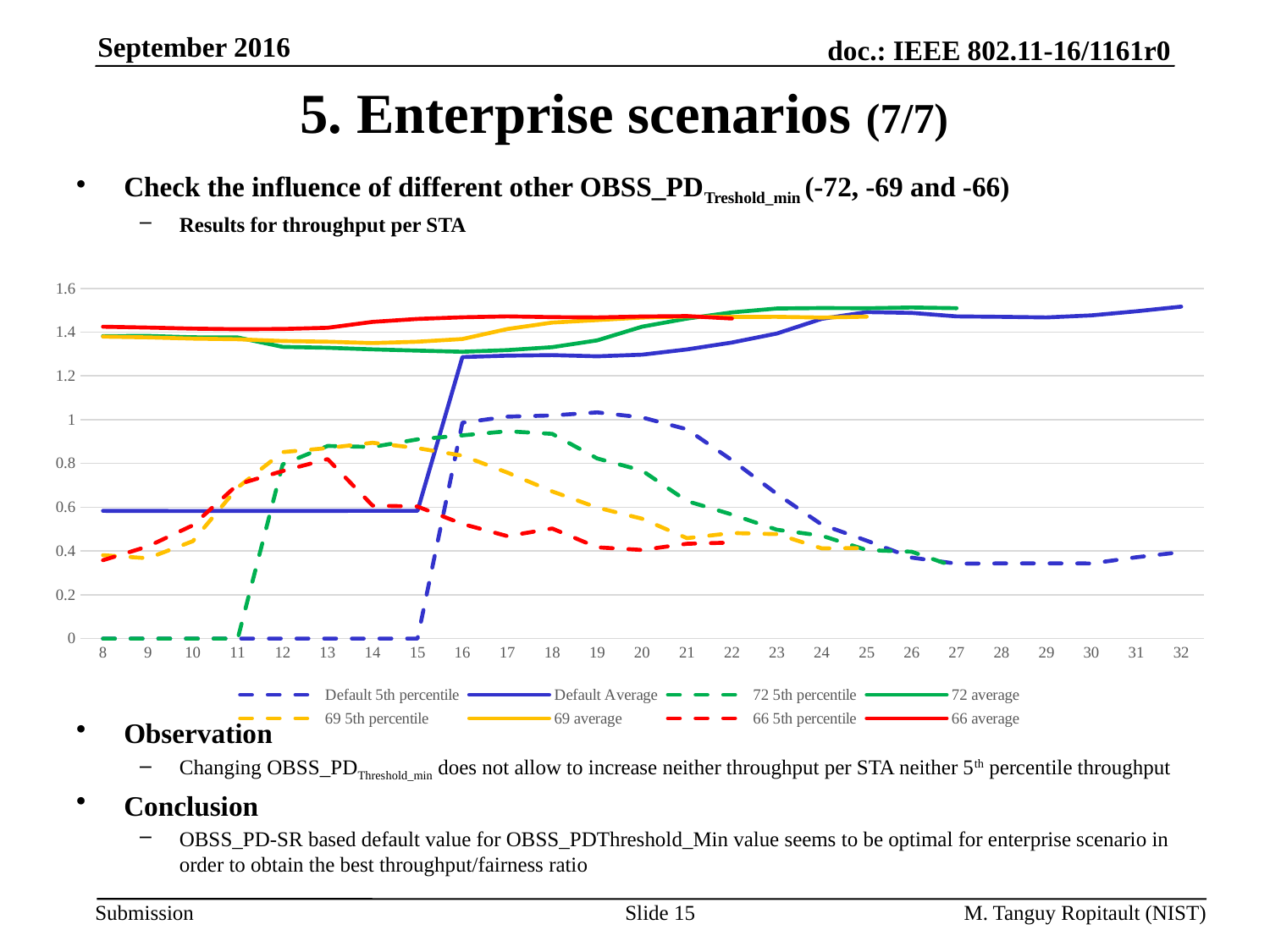
Is the value of 69 5th percentile at x = 12 greater or less than 0.6? greater How many x-axis points are plotted (from 8 to 32)? 25 What colour is the 66 average line? red Does the Default 5th percentile series rise or fall between x = 19 and x = 27? fall At x = 8, which is larger: Default Average or 66 average? 66 average What kind of chart is shown on the slide? line chart Is the value of Default 5th percentile at x = 19 greater or less than 0.8? greater At x = 12, which is larger: 69 5th percentile or Default 5th percentile? 69 5th percentile Is the value of 66 average at x = 8 greater or less than 1.2? greater How many series does the legend list? 8